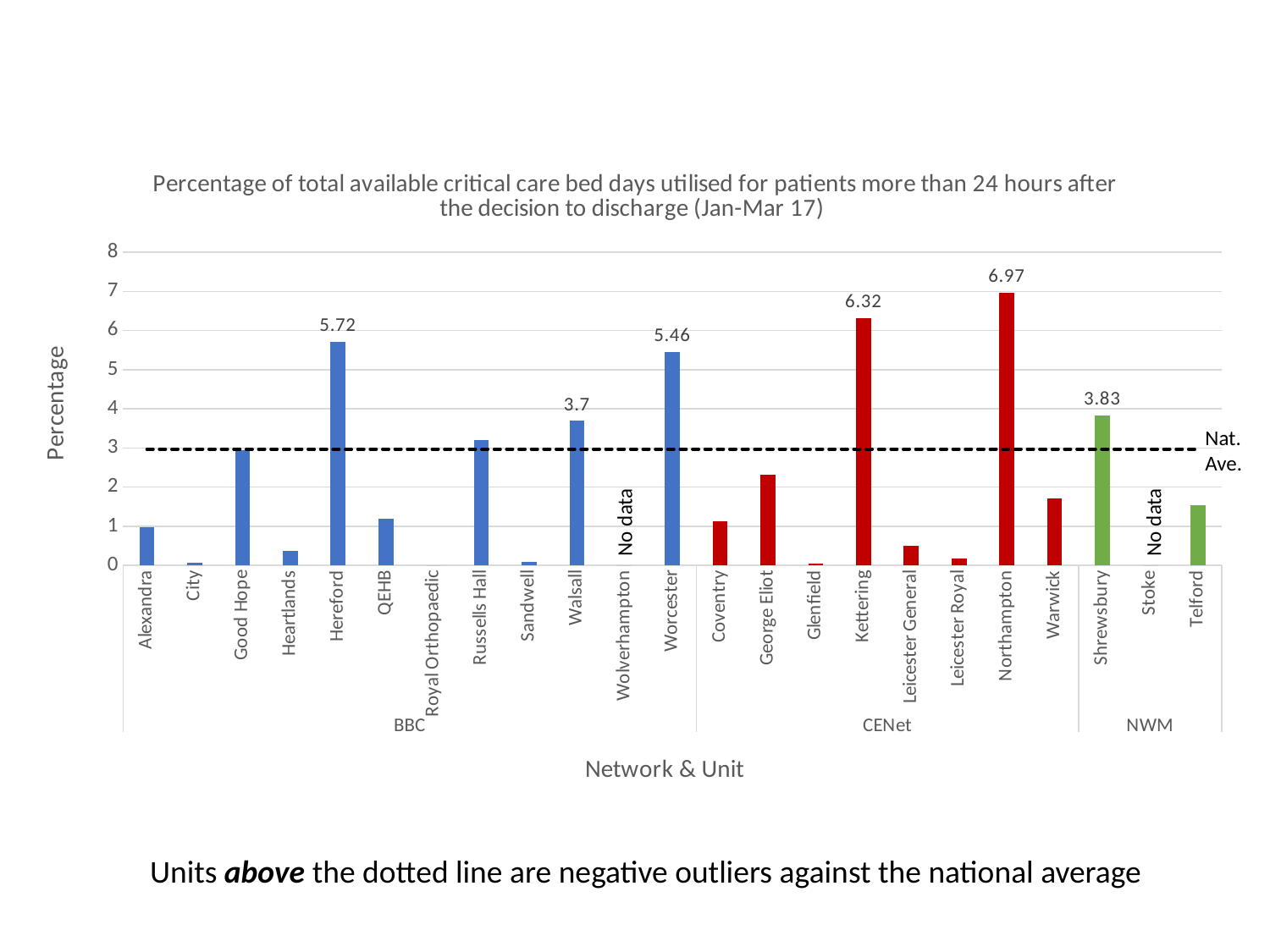
Is the value for Warwick greater or less than 2? less Is the value for George Eliot greater or less than 2? greater What kind of chart is shown on the slide? Bar chart What is the value for Shrewsbury? 3.83 What is the value for Northampton? 6.97 What is the value for Hereford? 5.72 What is the difference between the values for Hereford and Worcester? 0.26 What is the value for Walsall? 3.7 What is the difference between the values for Northampton and Kettering? 0.65 Which is larger, the value for Kettering or the value for Worcester? Kettering Which unit has the highest percentage? Northampton Which two units are marked as having no data? Wolverhampton and Stoke